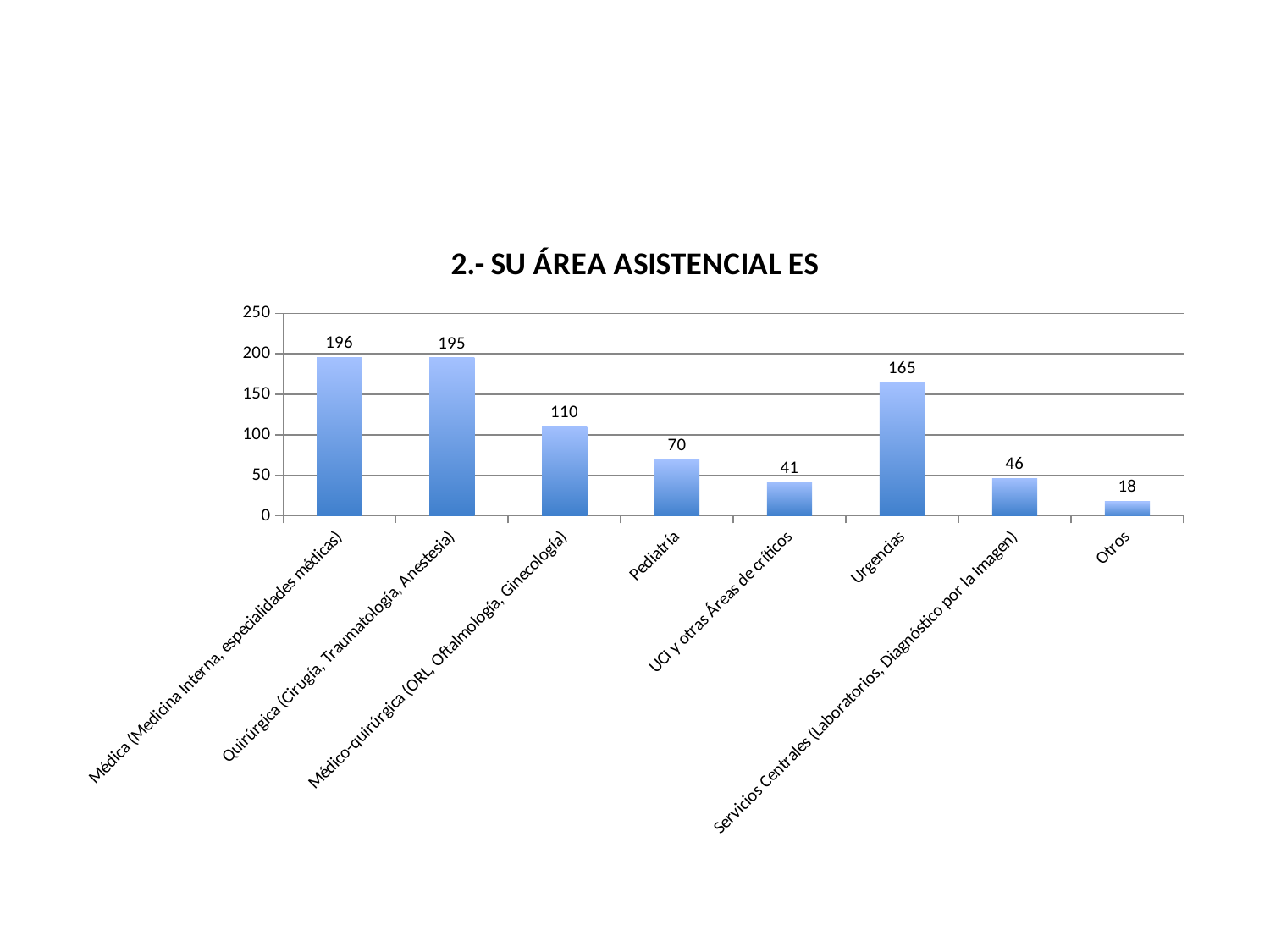
What is the value for Pediatría? 70 Which category has the lowest value? Otros What is the value for Urgencias? 165 What is the value for UCI y otras Áreas de críticos? 41 Is the value for Servicios Centrales (Laboratorios, Diagnóstico por la Imagen) greater or less than 50? less Which is larger, the value for Urgencias or the value for Médico-quirúrgica (ORL, Oftalmología, Ginecología)? Urgencias How many categories are shown in the chart? 8 What is the difference between the values for Urgencias and Pediatría? 95 What kind of chart is shown on the slide? bar chart What is the value for Otros? 18 What is the difference between the values for Médico-quirúrgica (ORL, Oftalmología, Ginecología) and Servicios Centrales (Laboratorios, Diagnóstico por la Imagen)? 64 What is the title of the chart? 2.- SU ÁREA ASISTENCIAL ES